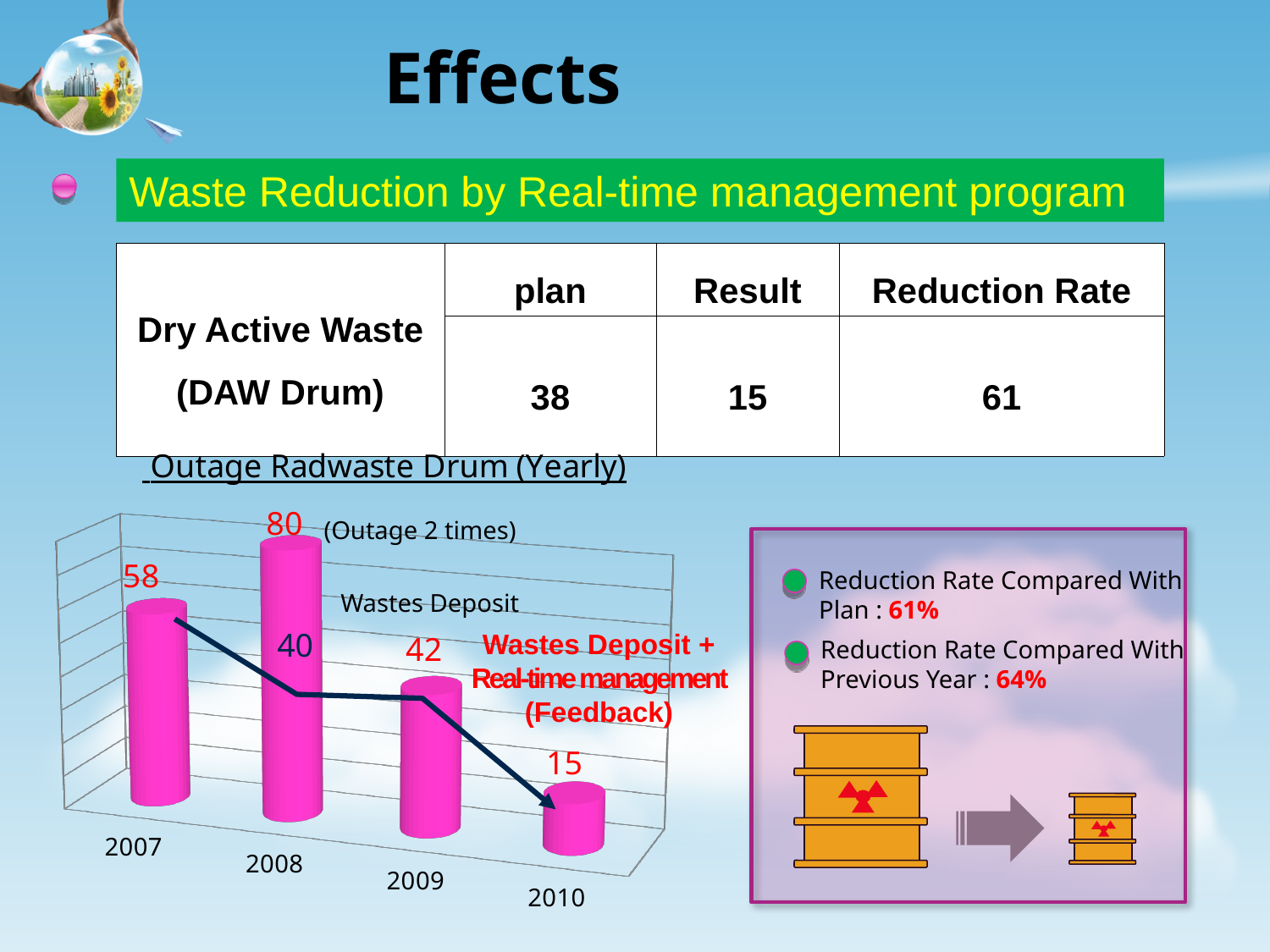
What is the value for 2008 in the Outage Radwaste Drum (Yearly) chart? 80 Which year has the highest value in the Outage Radwaste Drum (Yearly) chart? 2008 What is the difference between the 2008 and 2010 values in the Outage Radwaste Drum (Yearly) chart? 65 What is the value for 2007 in the Outage Radwaste Drum (Yearly) chart? 58 What kind of chart is the Outage Radwaste Drum (Yearly) chart? Bar chart In the Outage Radwaste Drum (Yearly) chart, which is larger, the value for 2007 or the value for 2009? 2007 How many years are shown in the Outage Radwaste Drum (Yearly) chart? 4 In the Outage Radwaste Drum (Yearly) chart, do the values rise or fall from 2008 to 2010? Fall What is the difference between the 2007 and 2009 values in the Outage Radwaste Drum (Yearly) chart? 16 What is the value for 2010 in the Outage Radwaste Drum (Yearly) chart? 15 What is the value for 2009 in the Outage Radwaste Drum (Yearly) chart? 42 Which year has the lowest value in the Outage Radwaste Drum (Yearly) chart? 2010